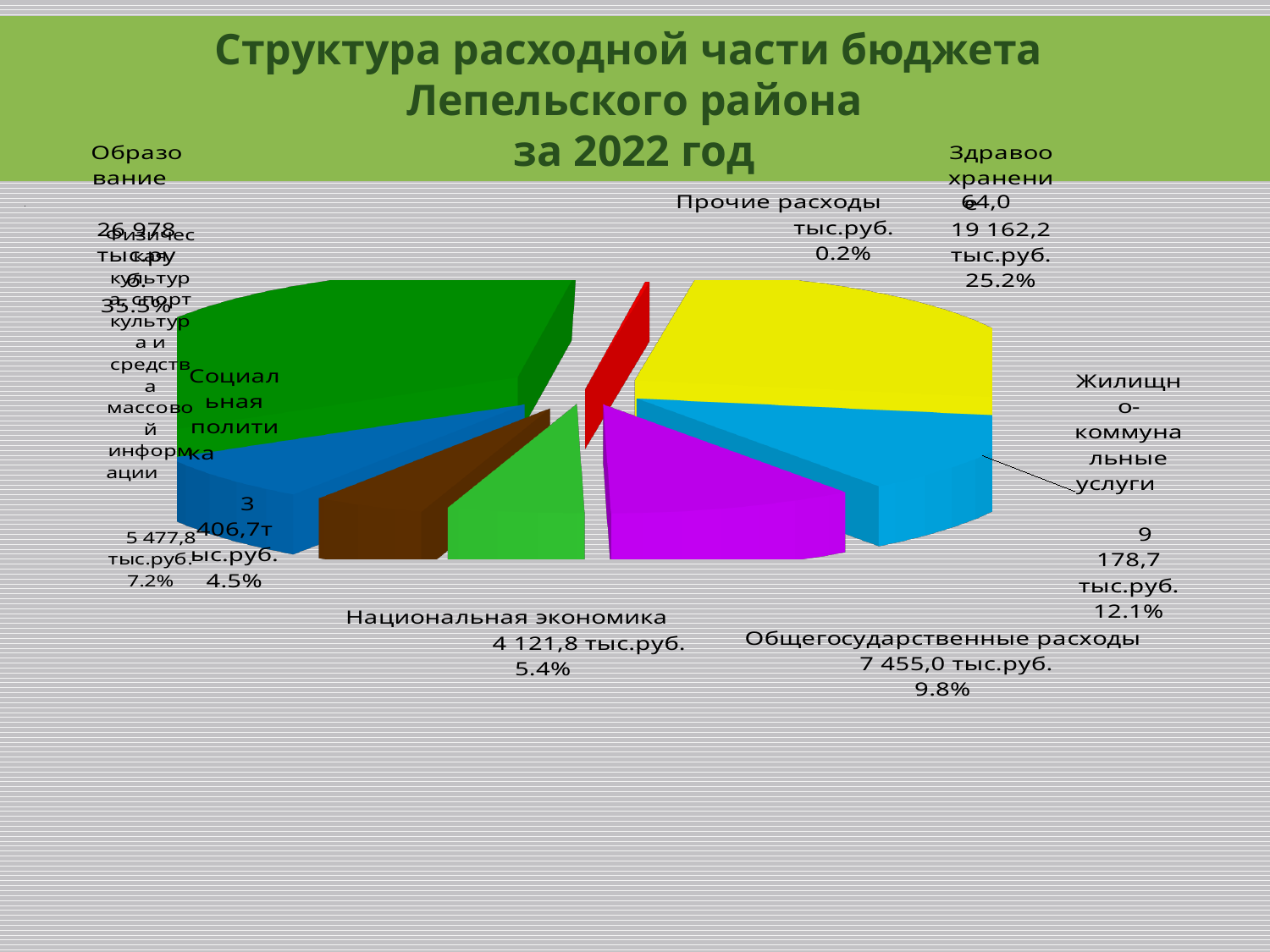
What is the title of the chart? Структура расходной части бюджета Лепельского района за 2022 год Which is larger, the value for Социальная политика or the value for Национальная экономика? Национальная экономика Which category has the smallest share of the budget? Прочие расходы Which category has the largest share of the budget? Образование What is the value for Национальная экономика? 4 121,8 тыс.руб. What share of the pie does Жилищно-коммунальные услуги represent? 12.1% What is the value for Здравоохранение? 19 162,2 тыс.руб. What is the difference in value between Здравоохранение and Жилищно-коммунальные услуги? 9 983,5 тыс.руб. How many slices does the pie chart have? 8 What is the value for Общегосударственные расходы? 7 455,0 тыс.руб. What kind of chart is shown on the slide? Pie chart What share of the pie does Здравоохранение represent? 25.2%